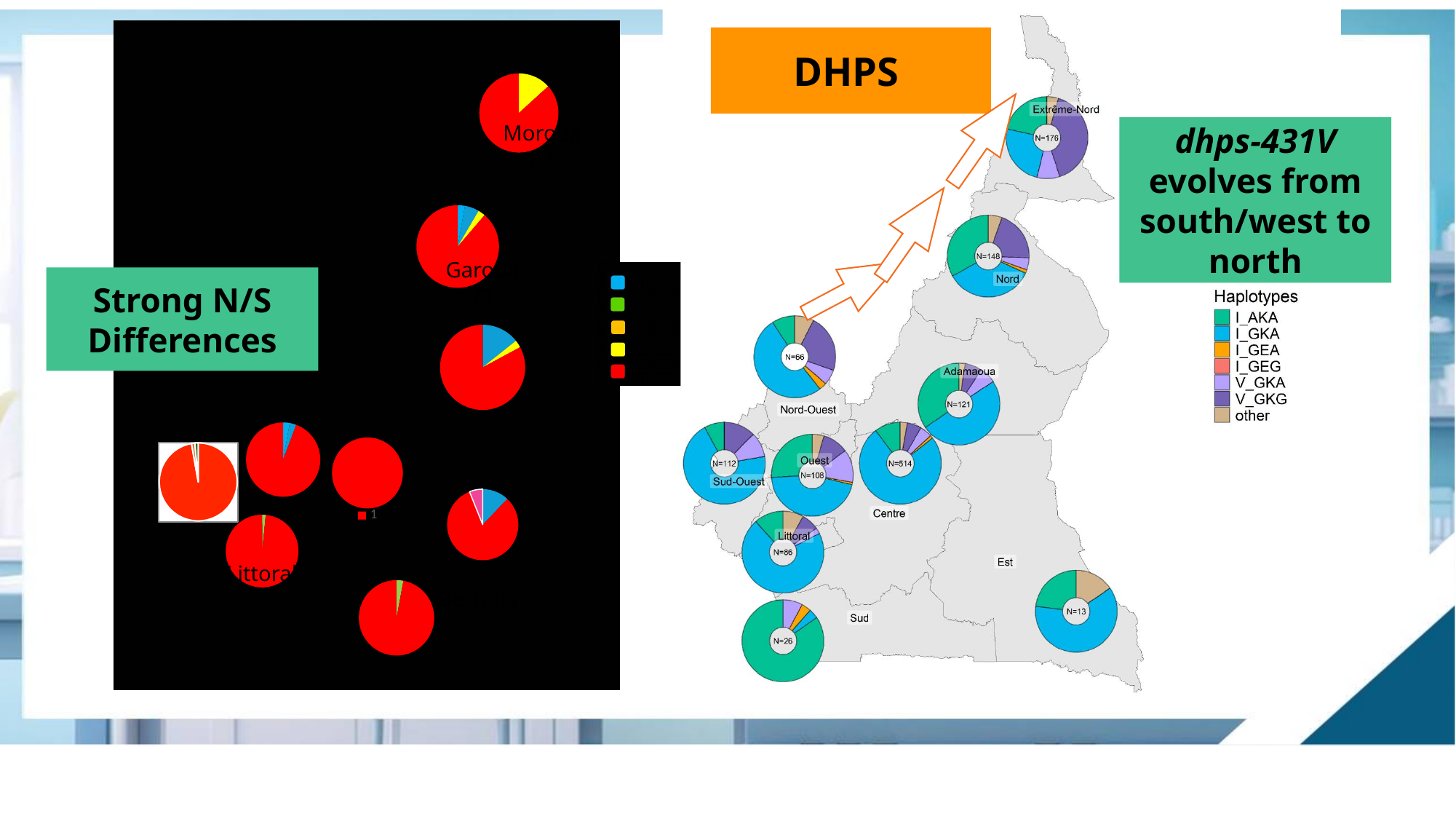
What is the title of the legend on the right-hand map chart? Haplotypes On the right-hand map chart, which has a larger N value, the Nord-Ouest pie or the Littoral pie? Littoral On the right-hand map chart, how many haplotypes does the legend list? 7 On the right-hand map chart, what is the N value shown for the Extrême-Nord pie? N=176 On the right-hand map chart, what is the sample size (N) shown for the Centre region pie? N=514 On the right-hand map chart, which region's pie has the largest N value? Centre On the right-hand map chart, what is the N value shown for the Sud region pie? N=26 What kind of charts are plotted on the left-hand black panel? Pie charts On the right-hand map chart, which pie has the smallest N value? N=13 (Est) On the right-hand map chart, how many regional pie charts are drawn on the map? 10 On the right-hand map chart, which haplotype makes up the largest share of the Sud (N=26) pie? I_AKA On the right-hand map chart, what is the difference between the N values of the Extrême-Nord pie and the Nord pie? 28